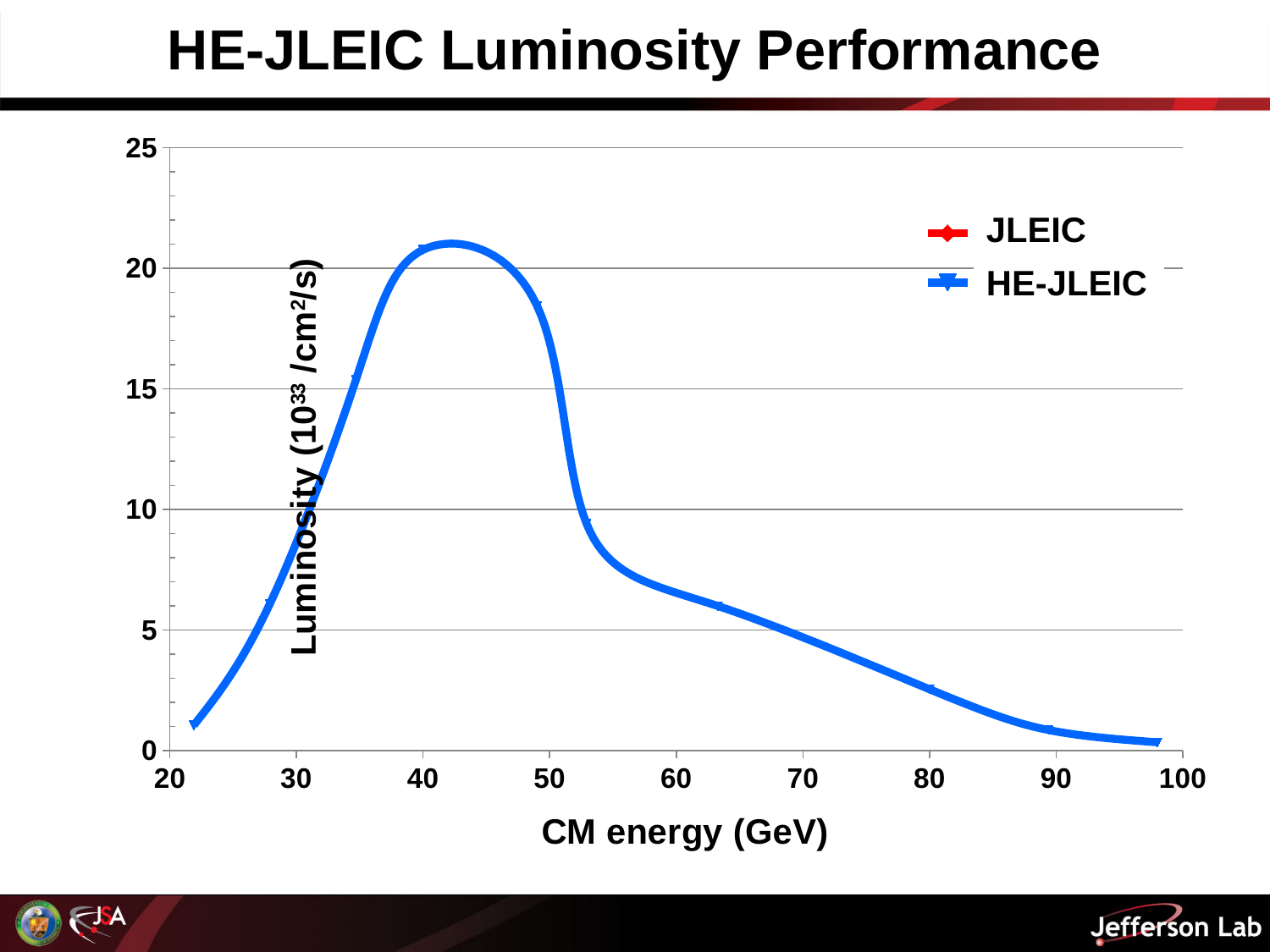
Is the peak value of the HE-JLEIC curve greater or less than 20? greater Is the HE-JLEIC value at a CM energy of 90 GeV greater or less than 5? less What is the label of the x axis? CM energy (GeV) What kind of chart is shown on the slide? line chart Does the HE-JLEIC curve rise or fall as CM energy increases from 20 GeV to 40 GeV? rise Does the HE-JLEIC curve rise or fall as CM energy increases from 50 GeV to 100 GeV? fall Is the HE-JLEIC value at a CM energy of 60 GeV greater or less than 10? less How many series does the legend list? 2 Which has the larger HE-JLEIC luminosity, a CM energy of 40 GeV or 80 GeV? 40 GeV What are the two series named in the legend? JLEIC and HE-JLEIC